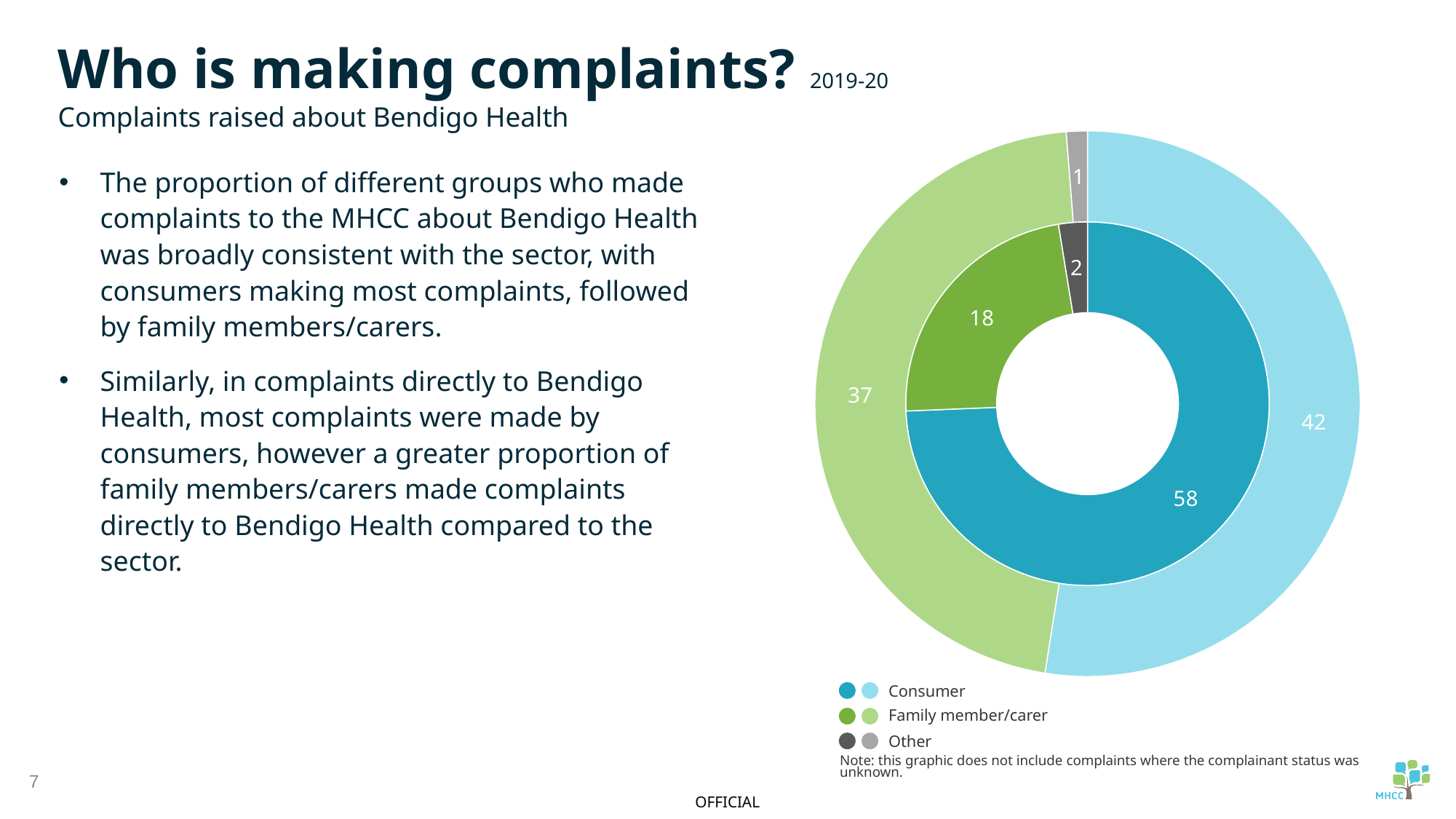
Is the Family member/carer value larger in the inner ring or the outer ring of the doughnut chart? Outer ring Which category has the largest value in the inner ring of the doughnut chart? Consumer In the inner ring of the doughnut chart, what is the value for Consumer? 58 In the inner ring of the doughnut chart, what is the value for Family member/carer? 18 In the outer ring of the doughnut chart, what is the value for Other? 1 In the inner ring, what is the difference between the Consumer value and the Family member/carer value? 40 What kind of chart is shown on the slide? Doughnut chart In the outer ring of the doughnut chart, what is the value for Consumer? 42 In the outer ring of the doughnut chart, what is the value for Family member/carer? 37 In the inner ring of the doughnut chart, what is the value for Other? 2 How many categories does the chart legend list? 3 Which category has the smallest value in the outer ring of the doughnut chart? Other